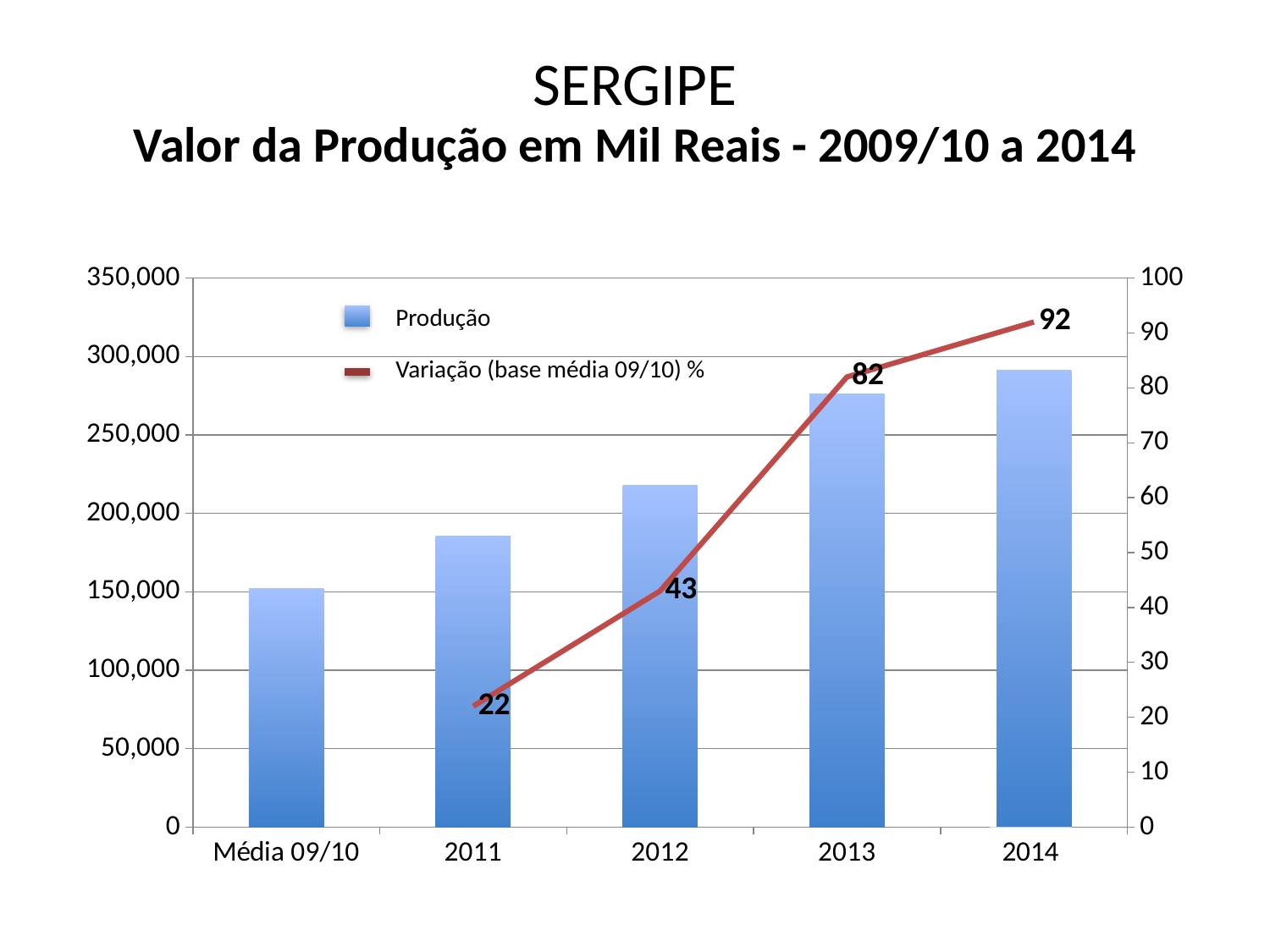
What is the difference between the Variação values for 2013 and 2012? 39 How many series does the legend list? 2 How many categories are shown on the x axis? 5 What is the value of Variação (base média 09/10) % for 2014? 92 Which year has the highest Produção bar? 2014 Which category has the lowest Produção bar? Média 09/10 Which is larger, the Produção bar for 2012 or for 2013? 2013 Is the Produção value for 2013 greater or less than 250,000? greater Is the Produção value for 2011 greater or less than 200,000? less What is the value of Variação (base média 09/10) % for 2011? 22 What is the value of Variação (base média 09/10) % for 2013? 82 Do the Produção bars rise or fall from Média 09/10 to 2014? rise